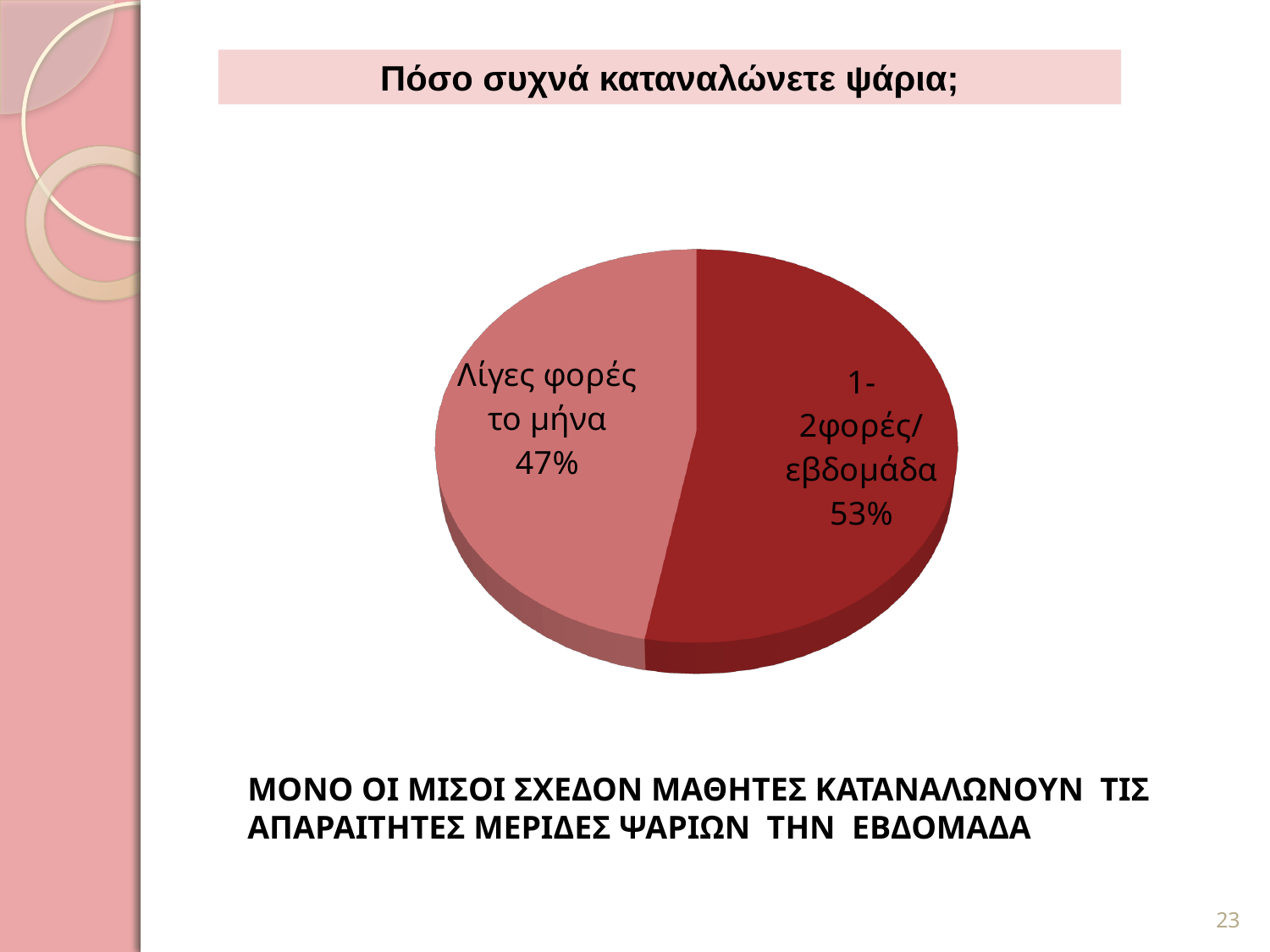
What percentage of the pie is labelled "Λίγες φορές το μήνα"? 47% Which slice of the pie is the smallest? Λίγες φορές το μήνα How many slices does the pie chart have? 2 What is the difference in percentage points between the "1-2φορές/εβδομάδα" slice and the "Λίγες φορές το μήνα" slice? 6 What percentage of the pie is labelled "1-2φορές/εβδομάδα"? 53% What share of the pie does the "Λίγες φορές το μήνα" slice represent? 47% What kind of chart is shown on the slide? pie chart Which is larger: the share for "1-2φορές/εβδομάδα" or the share for "Λίγες φορές το μήνα"? 1-2φορές/εβδομάδα What is the title of the slide above the pie chart? Πόσο συχνά καταναλώνετε ψάρια; Which slice of the pie is the largest? 1-2φορές/εβδομάδα Which slice of the pie is drawn in the darker red colour? 1-2φορές/εβδομάδα